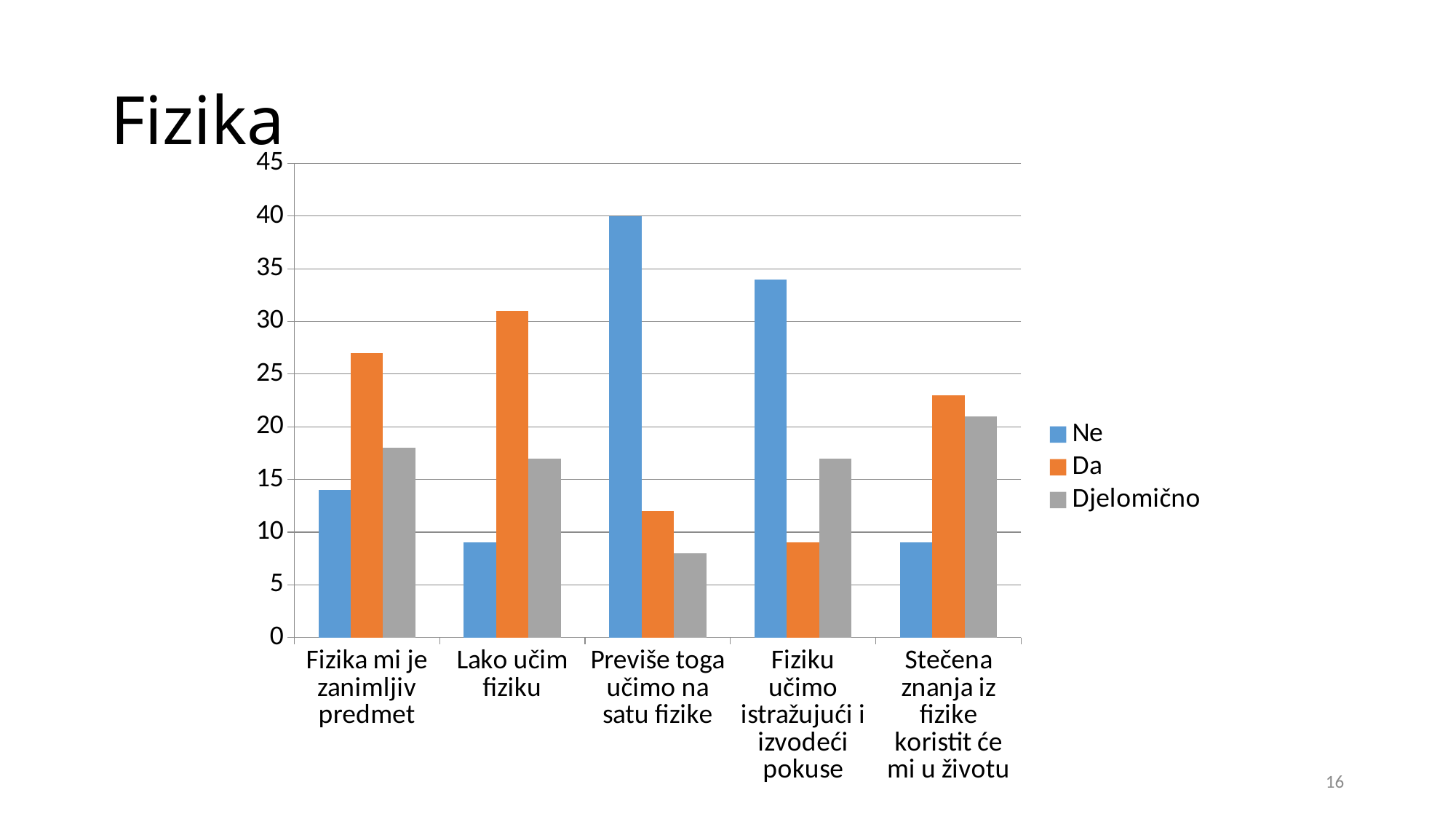
Is the Da value for "Fizika mi je zanimljiv predmet" greater or less than 25? greater Which legend entry is shown in orange? Da Which category has the lowest Djelomično value? Previše toga učimo na satu fizike What is the value of the Ne bar for "Previše toga učimo na satu fizike"? 40 For "Stečena znanja iz fizike koristit će mi u životu", which is larger: the Da value or the Ne value? Da Is the Ne value for "Lako učim fiziku" greater or less than 10? less Is the Ne value for "Fiziku učimo istražujući i izvodeći pokuse" greater or less than 30? greater How many categories are shown on the x axis? 5 Which category has the highest Ne value? Previše toga učimo na satu fizike What kind of chart is shown on the slide? bar chart How many series does the legend list? 3 Which category has the highest Da value? Lako učim fiziku